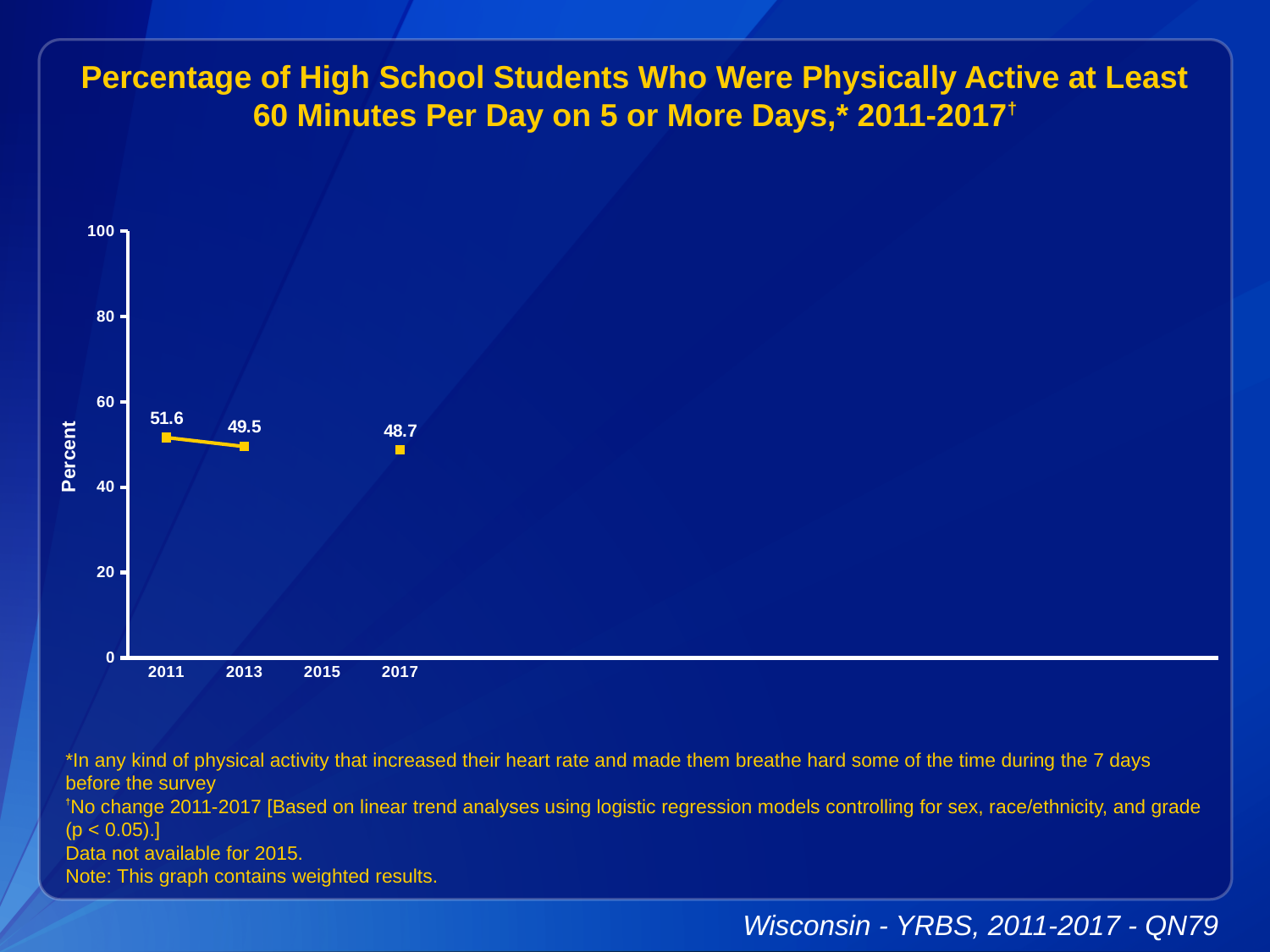
What kind of chart is shown on the slide? line chart What value is shown for 2013? 49.5 How many years have data points plotted on the chart? 3 Which is larger, the value for 2013 or the value for 2017? 2013 What is the label on the vertical axis? Percent Is the value for 2011 greater or less than 60? less What is the difference between the 2011 and 2017 values? 2.9 What value is shown for 2017? 48.7 What was the percentage of high school students who were physically active at least 60 minutes per day on 5 or more days in 2011? 51.6 Which year has the lowest plotted value? 2017 Which year has the highest value? 2011 What is the difference between the 2011 and 2013 values? 2.1